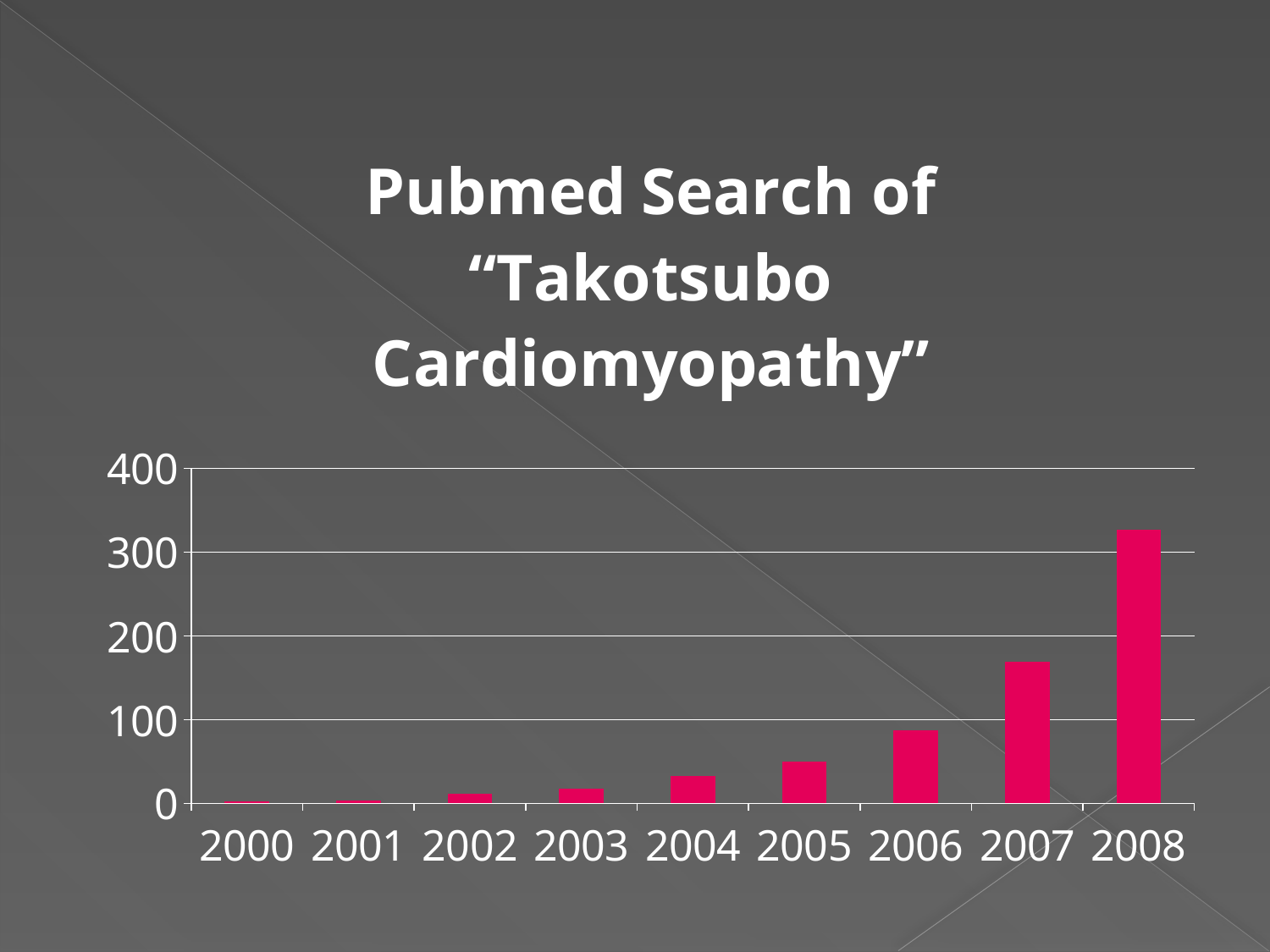
Is the value for 2007 greater or less than 200? less Is the value for 2005 greater or less than 100? less Do the values rise or fall from 2000 to 2008? rise Which is larger, the value for 2007 or the value for 2008? 2008 Which is larger, the value for 2005 or the value for 2006? 2006 What is the title of the chart? Pubmed Search of "Takotsubo Cardiomyopathy" How many years are shown on the x axis of the chart? 9 Which year has the highest value in the chart? 2008 What kind of chart is shown on the slide? bar chart Is the value for 2006 greater or less than 100? less